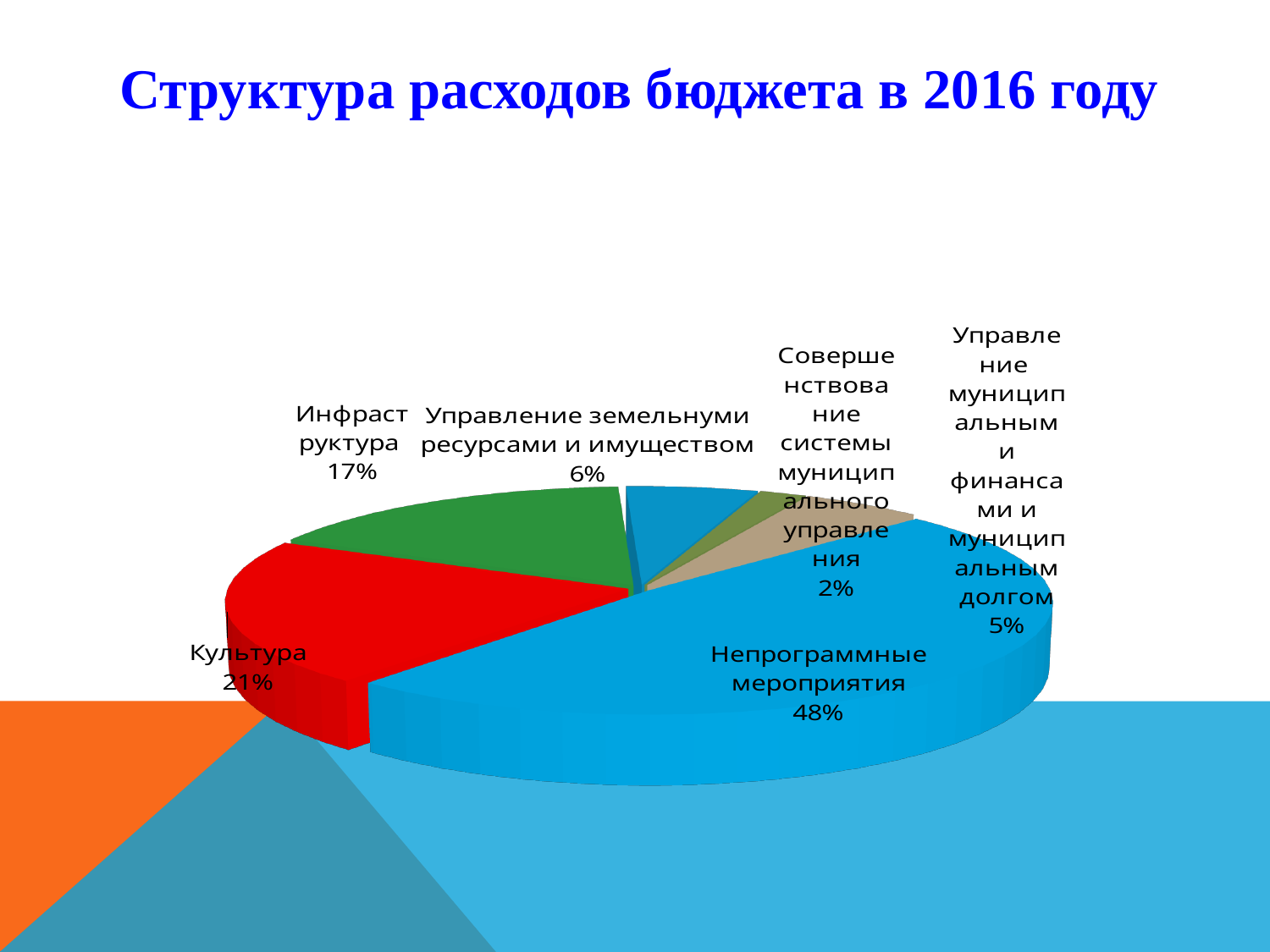
How many categories are shown in the pie chart? 6 What is the value shown for Управление земельными ресурсами и имуществом? 6% Which category has the smallest share of the pie? Совершенствование системы муниципального управления Which is larger, the share for Управление земельными ресурсами и имуществом or the share for Управление муниципальными финансами и муниципальным долгом? Управление земельными ресурсами и имуществом What is the value shown for Управление муниципальными финансами и муниципальным долгом? 5% What is the title of the slide? Структура расходов бюджета в 2016 году Which category has the largest share of the pie? Непрограммные мероприятия What is the difference between the shares of Культура and Инфраструктура? 4% What is the value shown for Инфраструктура? 17% What is the value shown for Культура? 21% What share of the pie does Непрограммные мероприятия take? 48% What kind of chart is shown on the slide? Pie chart